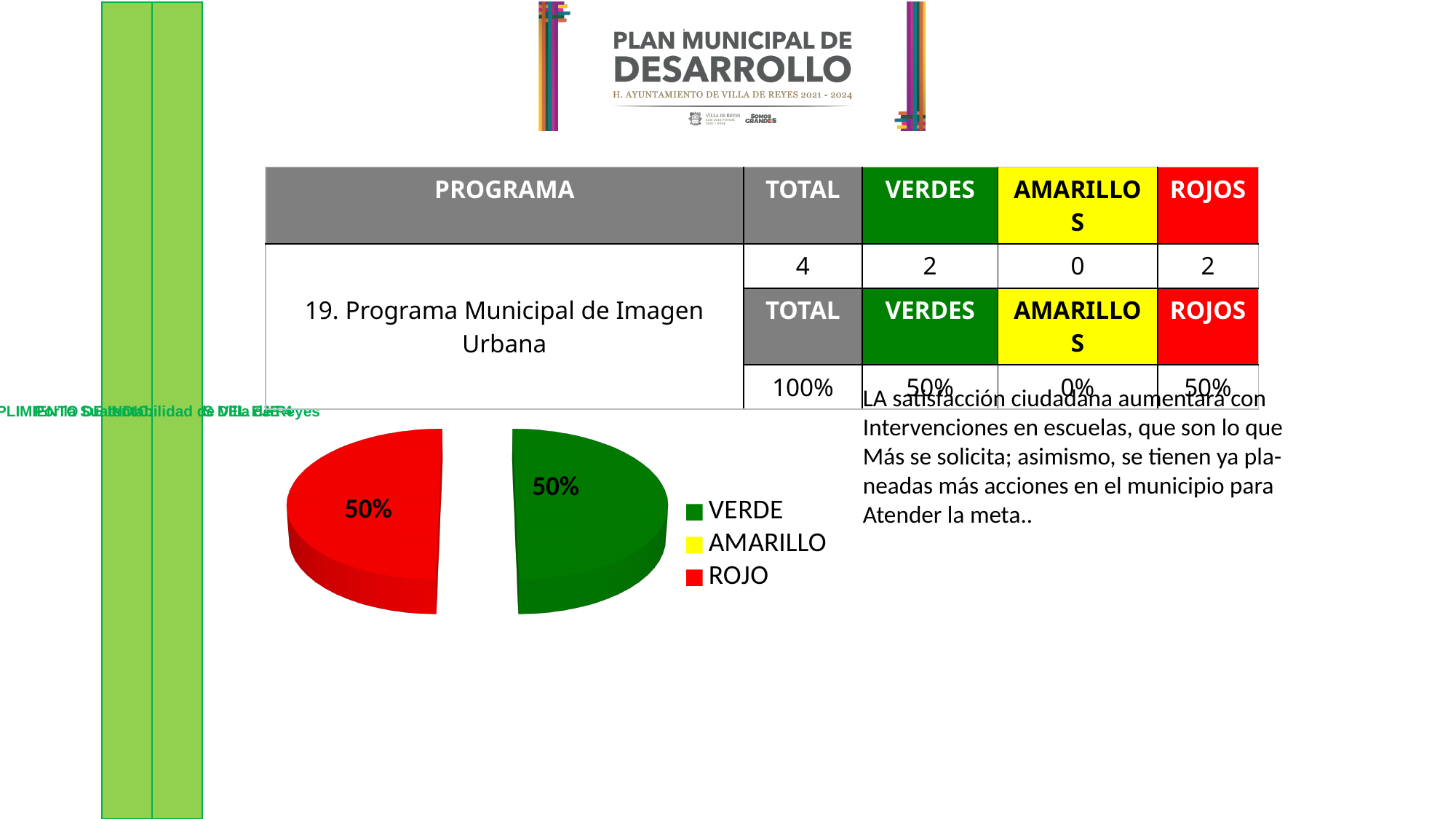
How many entries does the legend of the pie chart list? 3 What share of the pie chart does the ROJO slice represent? 50% What is the difference between the VERDE and ROJO shares in the pie chart? 0% What share of the pie chart does the VERDE slice represent? 50% How many slices are visible in the pie chart? 2 What kind of chart is shown on the slide? pie chart Which legend entry of the pie chart has no visible slice? AMARILLO What colour is the ROJO slice in the pie chart? red Is the share of the VERDE slice greater or less than 25%? greater What is the combined share of the VERDE and ROJO slices in the pie chart? 100%